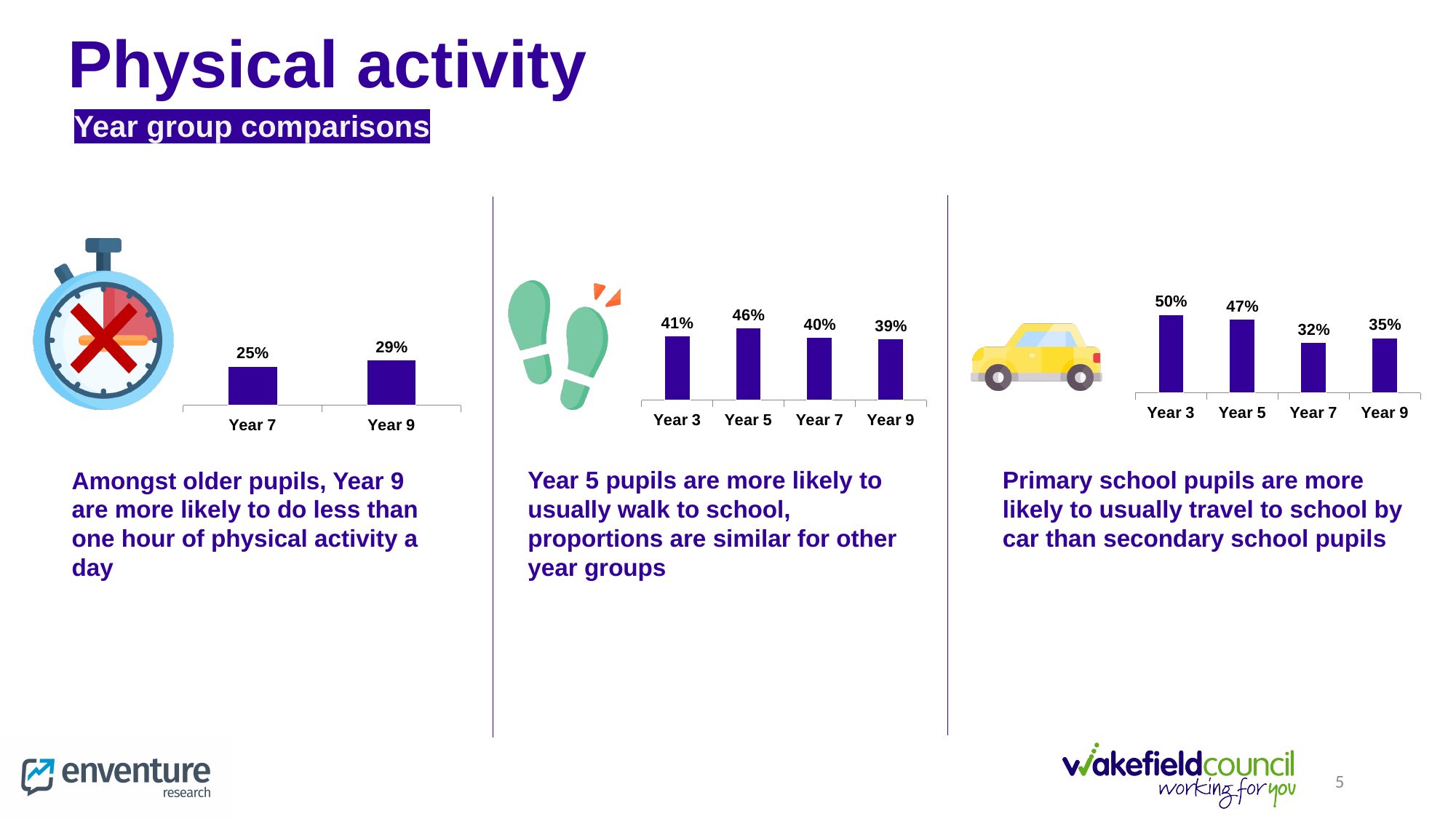
In the right chart (usually travel to school by car), what is the difference between Year 3 and Year 7? 18 percentage points In the left chart (less than one hour of physical activity a day), what is the difference between Year 9 and Year 7? 4 percentage points In the middle chart (usually walk to school), what is the value for Year 5? 46% In the right chart (usually travel to school by car), which is larger, Year 5 or Year 9? Year 5 In the left chart (less than one hour of physical activity a day), how many year groups are shown? 2 In the middle chart (usually walk to school), what is the difference between Year 5 and Year 9? 7 percentage points In the left chart (less than one hour of physical activity a day), what is the value for Year 9? 29% In the middle chart (usually walk to school), which year group has the lowest value? Year 9 In the middle chart (usually walk to school), which year group has the highest value? Year 5 In the right chart (usually travel to school by car), what is the value for Year 7? 32% In the right chart (usually travel to school by car), which year group has the highest value? Year 3 What type of chart is the right chart (usually travel to school by car)? Bar chart